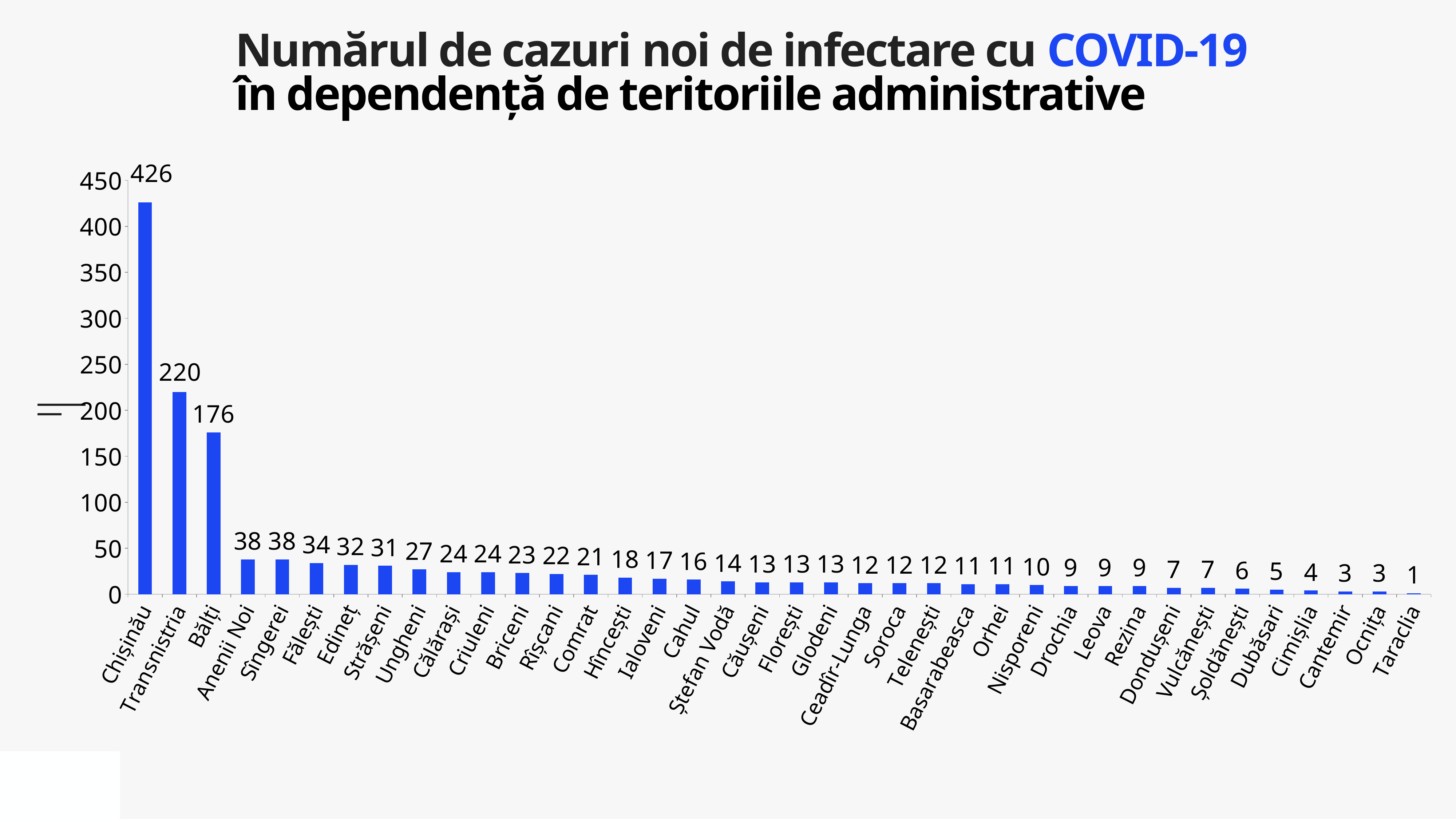
What is the difference between the values for Chișinău and Transnistria? 206 What kind of chart is shown on the slide? bar chart Which territory has the lowest number of new cases? Taraclia Which has a larger value, Fălești or Edineț? Fălești What is the value for Ungheni? 27 Is the value for Transnistria greater or less than 200? greater What is the value for Cahul? 16 What is the value for Bălți? 176 What is the value for Chișinău? 426 How many territories are shown on the chart? 38 Do the values rise or fall from left to right along the x axis? fall Which territory has the highest number of new cases? Chișinău